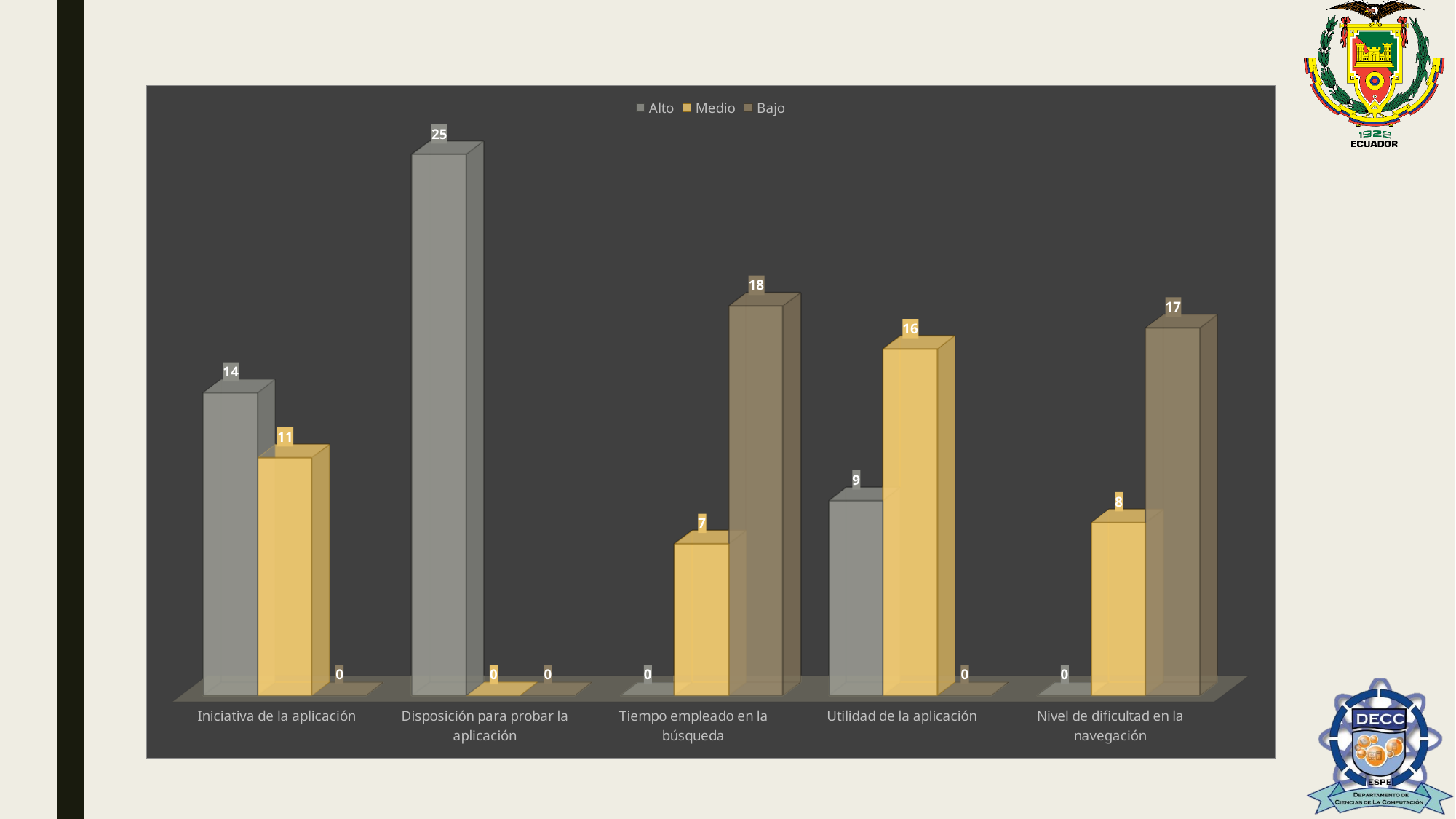
What is the Medio value for Utilidad de la aplicación? 16 What are the three series named in the legend? Alto, Medio, Bajo What kind of chart is shown on the slide? Bar chart Which category has the highest Alto value? Disposición para probar la aplicación How many series does the legend list? 3 What is the Alto value for Iniciativa de la aplicación? 14 Which category has the lowest Medio value? Disposición para probar la aplicación Which is larger for Utilidad de la aplicación, the Alto value or the Medio value? Medio What is the Bajo value for Tiempo empleado en la búsqueda? 18 How many categories are shown on the x axis? 5 What is the Bajo value for Nivel de dificultad en la navegación? 17 What is the difference between the Alto and Medio values for Iniciativa de la aplicación? 3